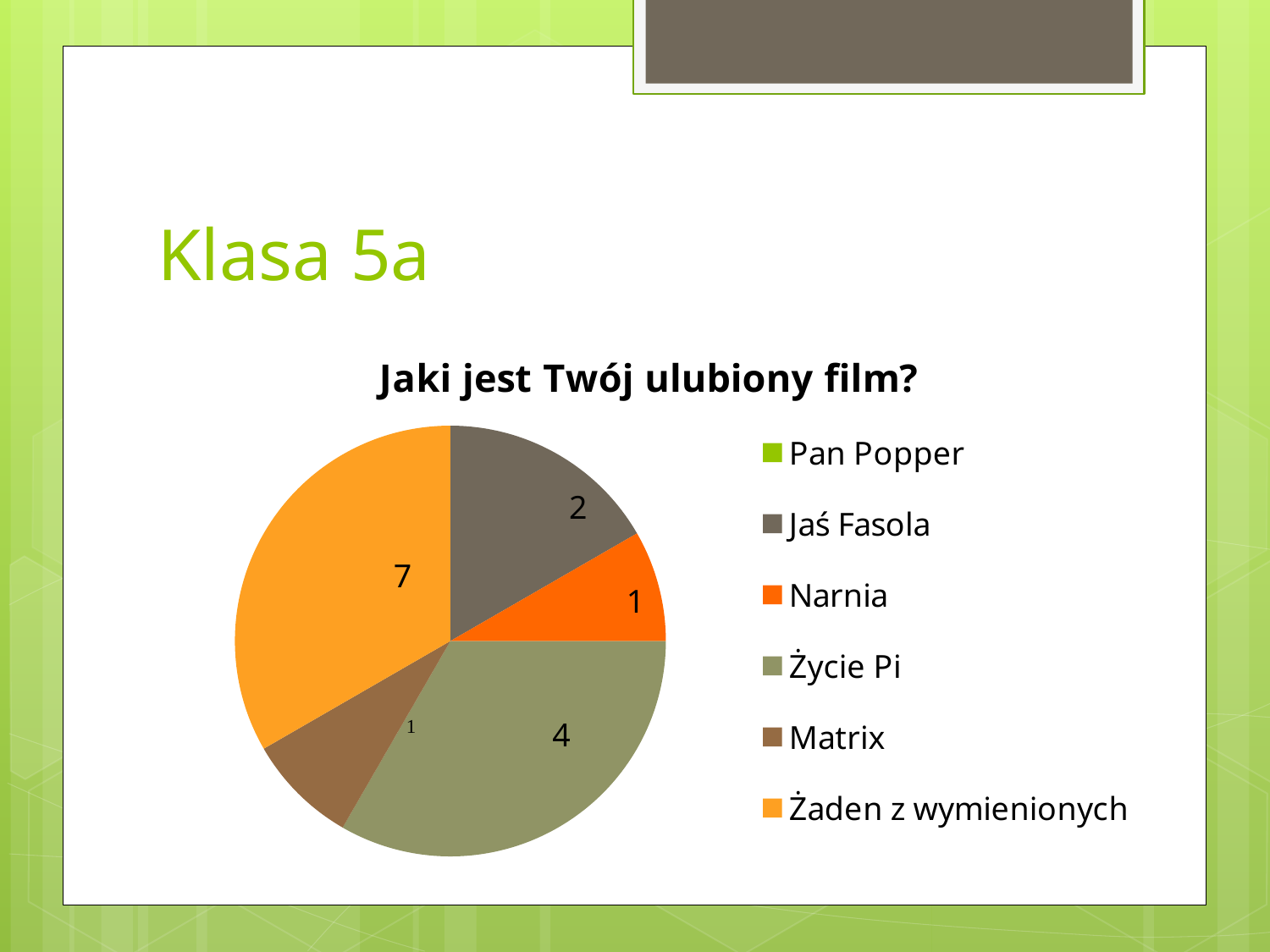
Which is larger, the value for "Jaś Fasola" or the value for "Życie Pi"? Życie Pi What is the value for "Żaden z wymienionych" in the pie chart? 7 What is the difference between the values for "Żaden z wymienionych" and "Życie Pi"? 3 What is the value for "Życie Pi" in the pie chart? 4 What is the title of the pie chart? Jaki jest Twój ulubiony film? What colour is the "Matrix" slice in the pie chart? brown How many entries does the legend of the pie chart list? 6 What type of chart is shown on the slide? pie chart What is the value for "Jaś Fasola" in the pie chart? 2 What is the value for "Narnia" in the pie chart? 1 What is the difference between the values for "Życie Pi" and "Jaś Fasola"? 2